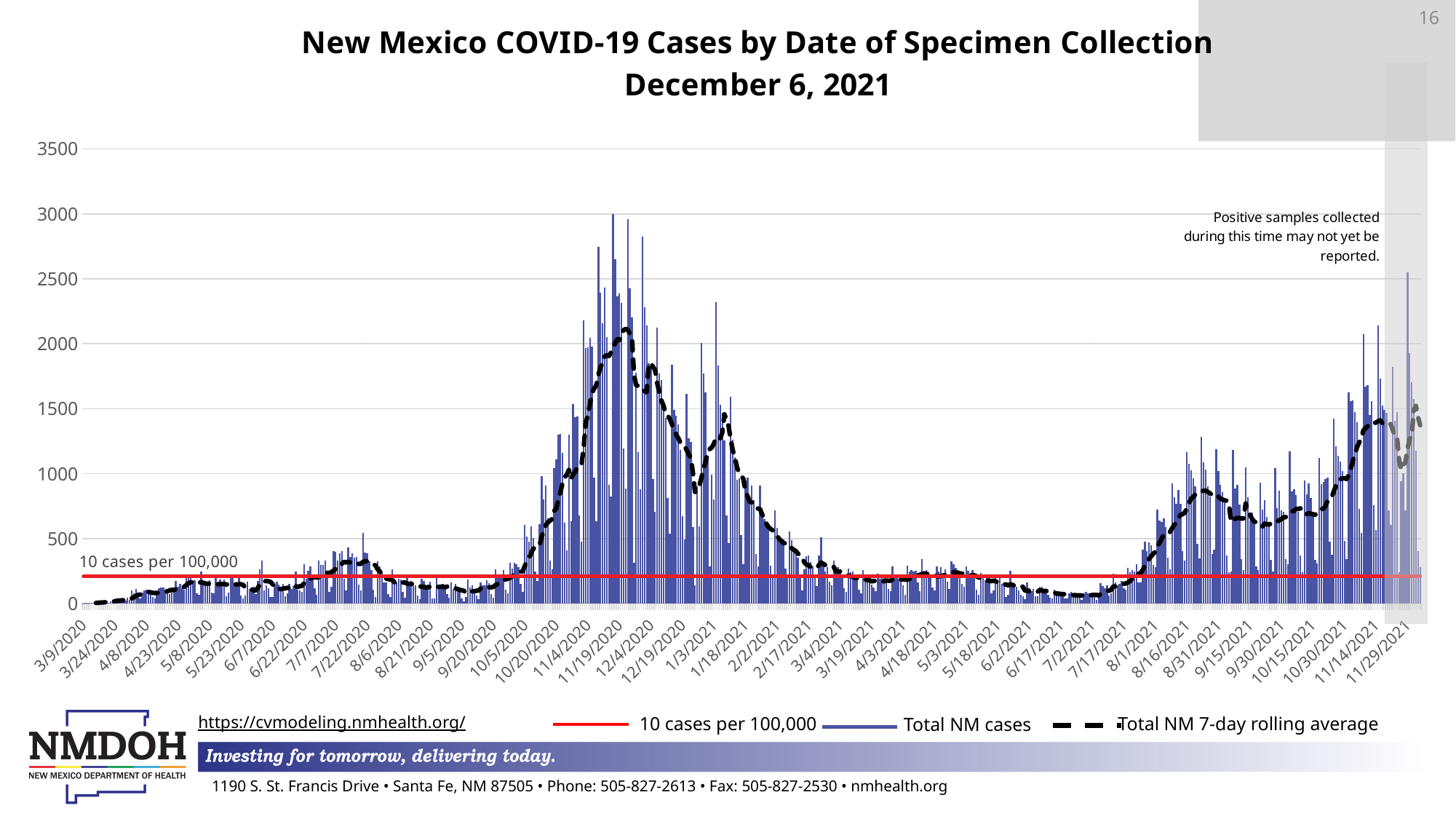
Is the highest daily case bar near 11/19/2020 greater or less than 2500? greater How many series does the legend list? 3 What does the red horizontal line represent according to the legend? 10 cases per 100,000 Does the Total NM 7-day rolling average rise or fall between 11/19/2020 and 3/4/2021? fall Around which x-axis date do the daily case bars reach their highest values? 11/19/2020 What kind of chart is shown on the slide? bar chart What is the title of the chart? New Mexico COVID-19 Cases by Date of Specimen Collection December 6, 2021 Is the Total NM 7-day rolling average around 8/16/2021 greater or less than 500? greater Is the Total NM 7-day rolling average around 7/7/2020 greater or less than 500? less Does the Total NM 7-day rolling average rise or fall between 7/17/2021 and 8/16/2021? rise What is the highest value shown on the y-axis? 3500